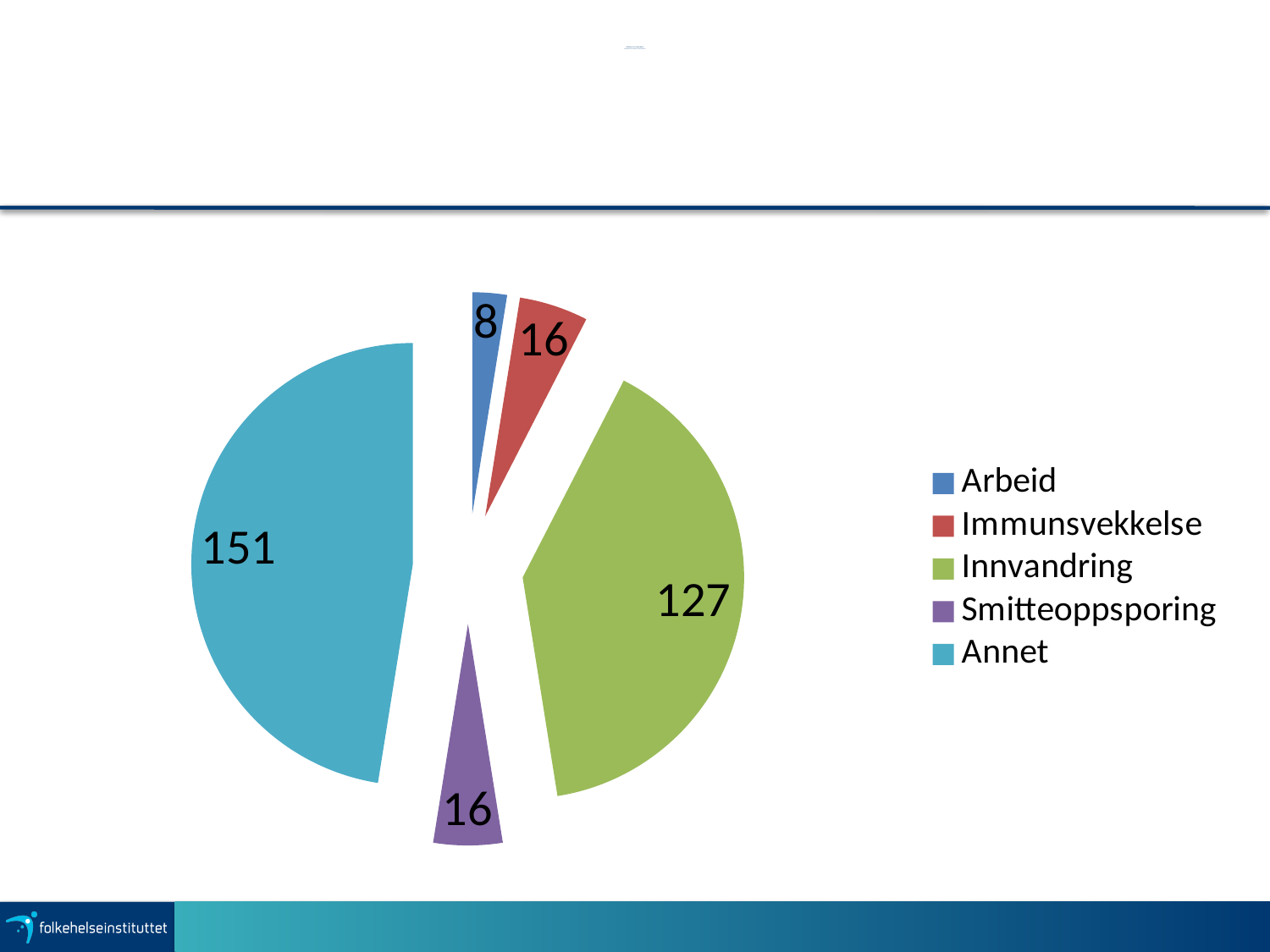
Which category has the largest slice of the pie? Annet What is the value for Innvandring? 127 What is the value for Arbeid? 8 Which category is shown in green in the pie chart? Innvandring What is the value for Immunsvekkelse? 16 What is the difference between the values for Annet and Innvandring? 24 What type of chart is shown on the slide? Pie chart Which is larger, the value for Innvandring or the value for Annet? Annet Which category has the smallest slice of the pie? Arbeid How many slices does the pie chart have? 5 What is the value for Annet? 151